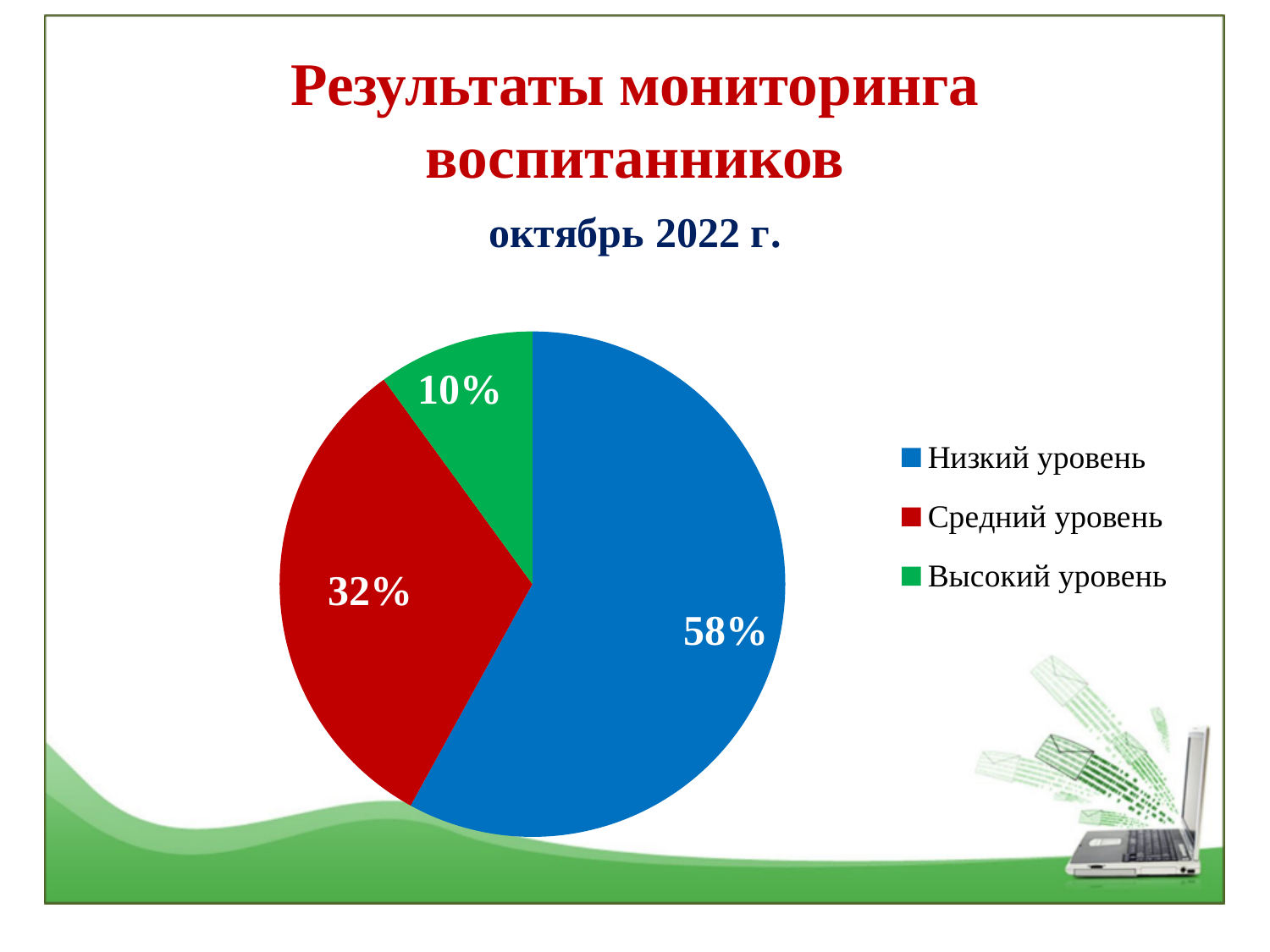
What share of the pie does Средний уровень have? 32% What colour is the slice for Высокий уровень? green Which category has the smallest slice of the pie? Высокий уровень What share of the pie does Высокий уровень have? 10% How many categories does the pie chart have? 3 What type of chart is shown on the slide? pie chart What period is shown in the subtitle above the chart? октябрь 2022 г. Which is larger, the slice for Средний уровень or the slice for Высокий уровень? Средний уровень What is the difference in percentage points between Низкий уровень and Средний уровень? 26 What is the difference in percentage points between Средний уровень and Высокий уровень? 22 What share of the pie does Низкий уровень have? 58% Which category has the largest slice of the pie? Низкий уровень